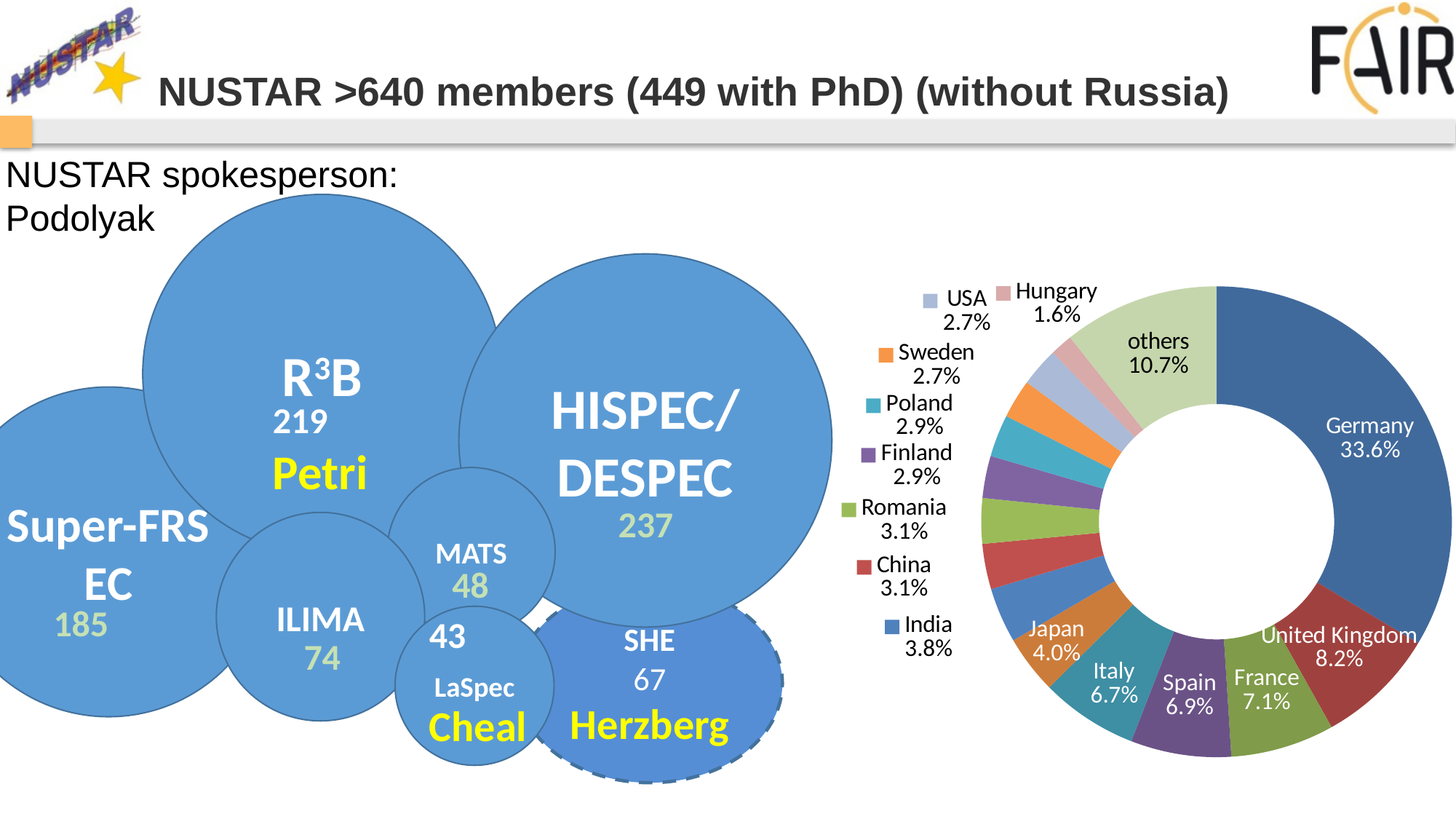
In the doughnut chart on the right, which country has the smallest share? Hungary In the bubble diagram on the left, which collaboration has the highest number of members? HISPEC/DESPEC In the doughnut chart on the right, what share does the United Kingdom have? 8.2% In the doughnut chart on the right, what share does India have? 3.8% In the bubble diagram on the left, what number is shown for HISPEC/DESPEC? 237 What kind of chart is shown on the right of the slide? Doughnut (pie) chart How many slices does the doughnut chart on the right have? 15 In the doughnut chart on the right, what share does Germany have? 33.6% In the doughnut chart on the right, which has the larger share, Italy or Japan? Italy In the doughnut chart on the right, which country has the largest share? Germany In the doughnut chart on the right, what is the difference between the shares of France and Spain? 0.2 percentage points In the doughnut chart on the right, what share is labelled 'others'? 10.7%